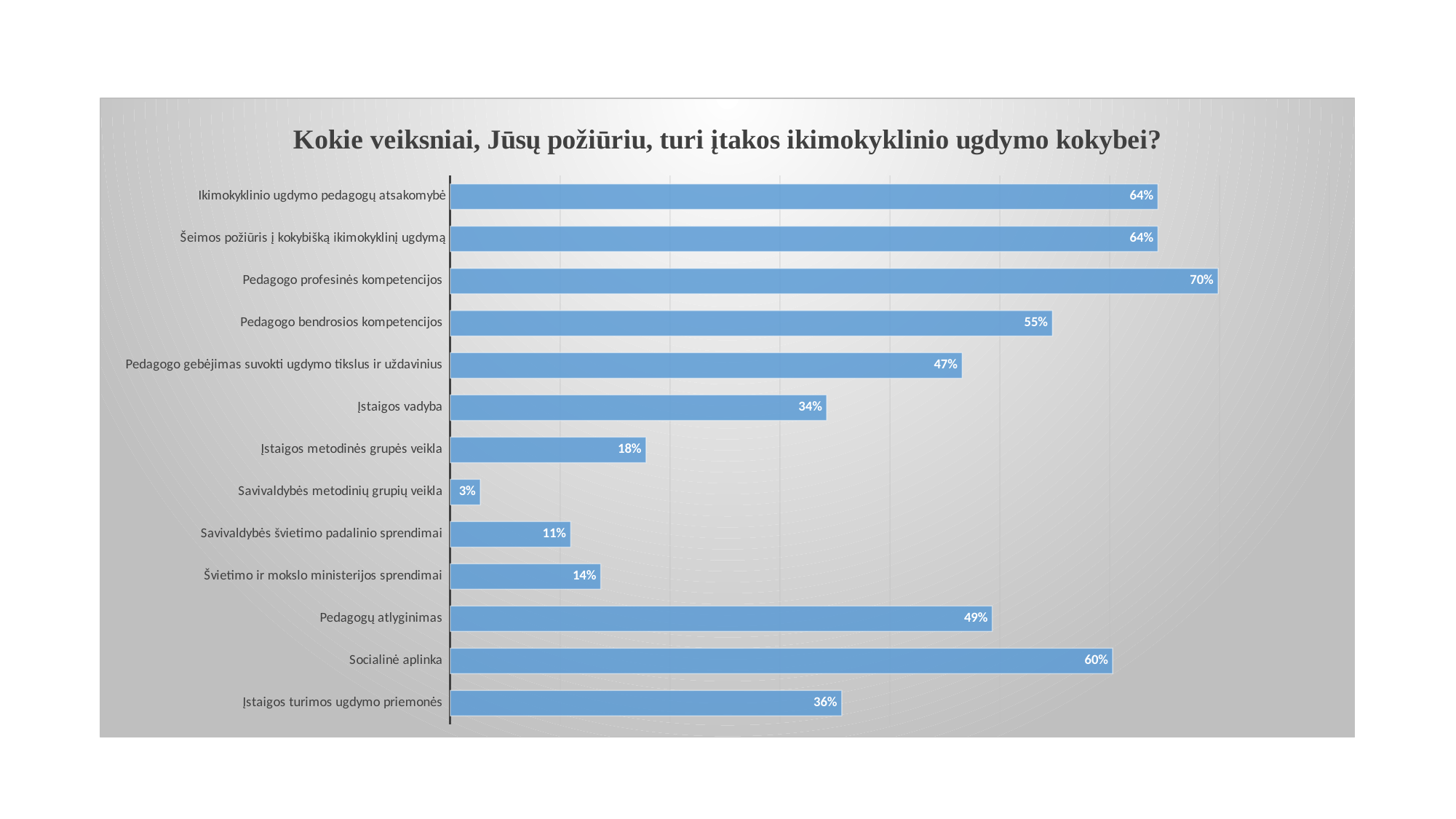
Which category has the lowest value? Savivaldybės metodinių grupių veikla What is the difference between the values for Pedagogų atlyginimas and Įstaigos turimos ugdymo priemonės? 13% What is the value for Pedagogo profesinės kompetencijos? 70% What is the value for Savivaldybės švietimo padalinio sprendimai? 11% How many categories are shown in the chart? 13 What kind of chart is shown on the slide? Bar chart What is the value for Socialinė aplinka? 60% What is the difference between the values for Pedagogo profesinės kompetencijos and Pedagogo bendrosios kompetencijos? 15% What is the value for Įstaigos vadyba? 34% Which is larger: the value for Įstaigos metodinės grupės veikla or the value for Švietimo ir mokslo ministerijos sprendimai? Įstaigos metodinės grupės veikla Which category has the highest value? Pedagogo profesinės kompetencijos What is the title of the chart? Kokie veiksniai, Jūsų požiūriu, turi įtakos ikimokyklinio ugdymo kokybei?